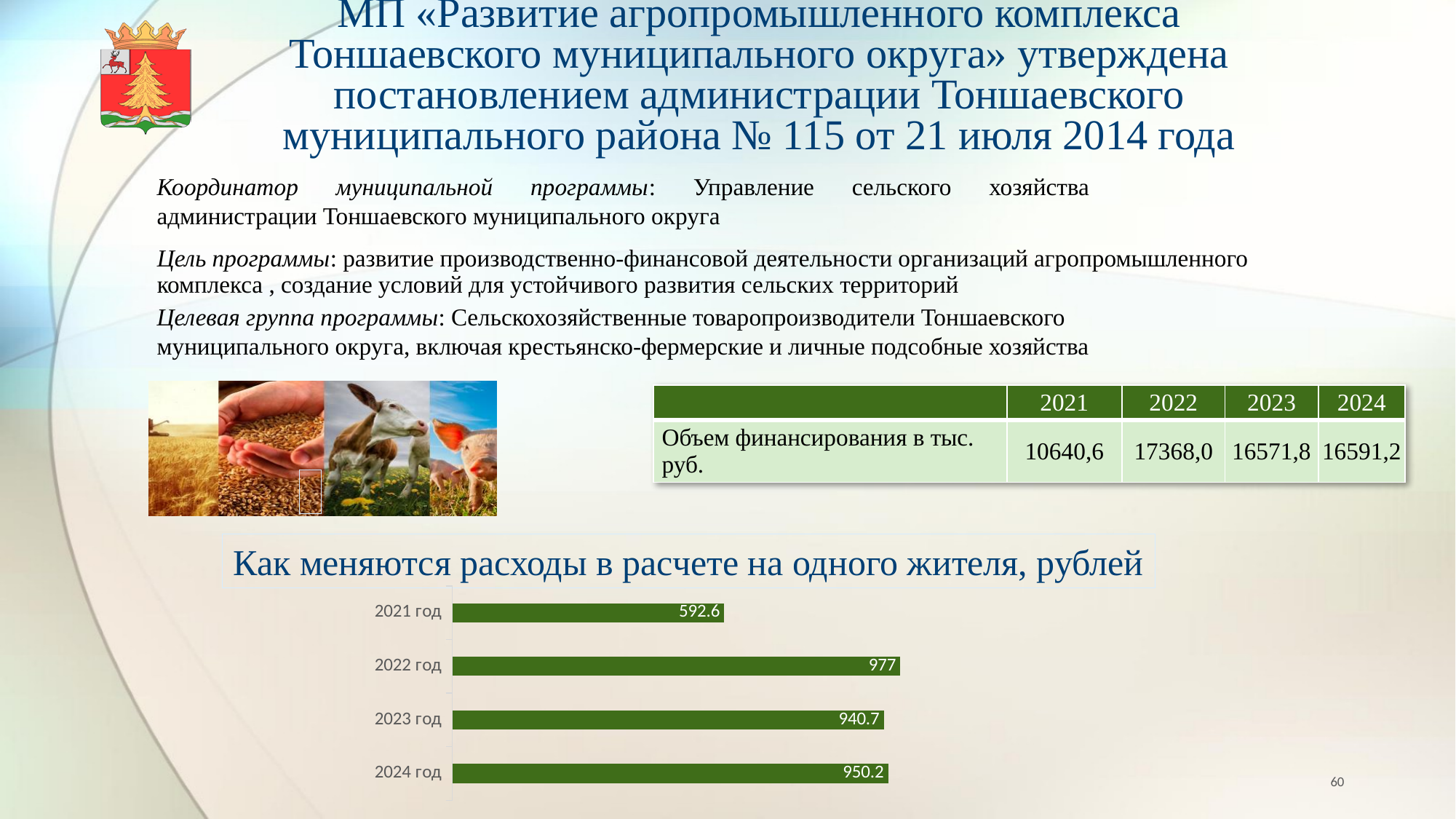
How many bars are shown in the chart? 4 What is the title of the chart? Как меняются расходы в расчете на одного жителя, рублей What is the value for 2024 год in the chart? 950.2 What is the difference between the values for 2024 год and 2023 год? 9.5 What is the value for 2023 год in the chart? 940.7 Which year has the lowest value in the chart? 2021 год What type of chart is shown on the slide? Bar chart Which is larger, the value for 2023 год or the value for 2021 год? 2023 год What is the value for 2022 год in the chart? 977 Which year has the highest value in the chart? 2022 год What is the value for 2021 год in the chart? 592.6 What is the difference between the values for 2022 год and 2021 год? 384.4